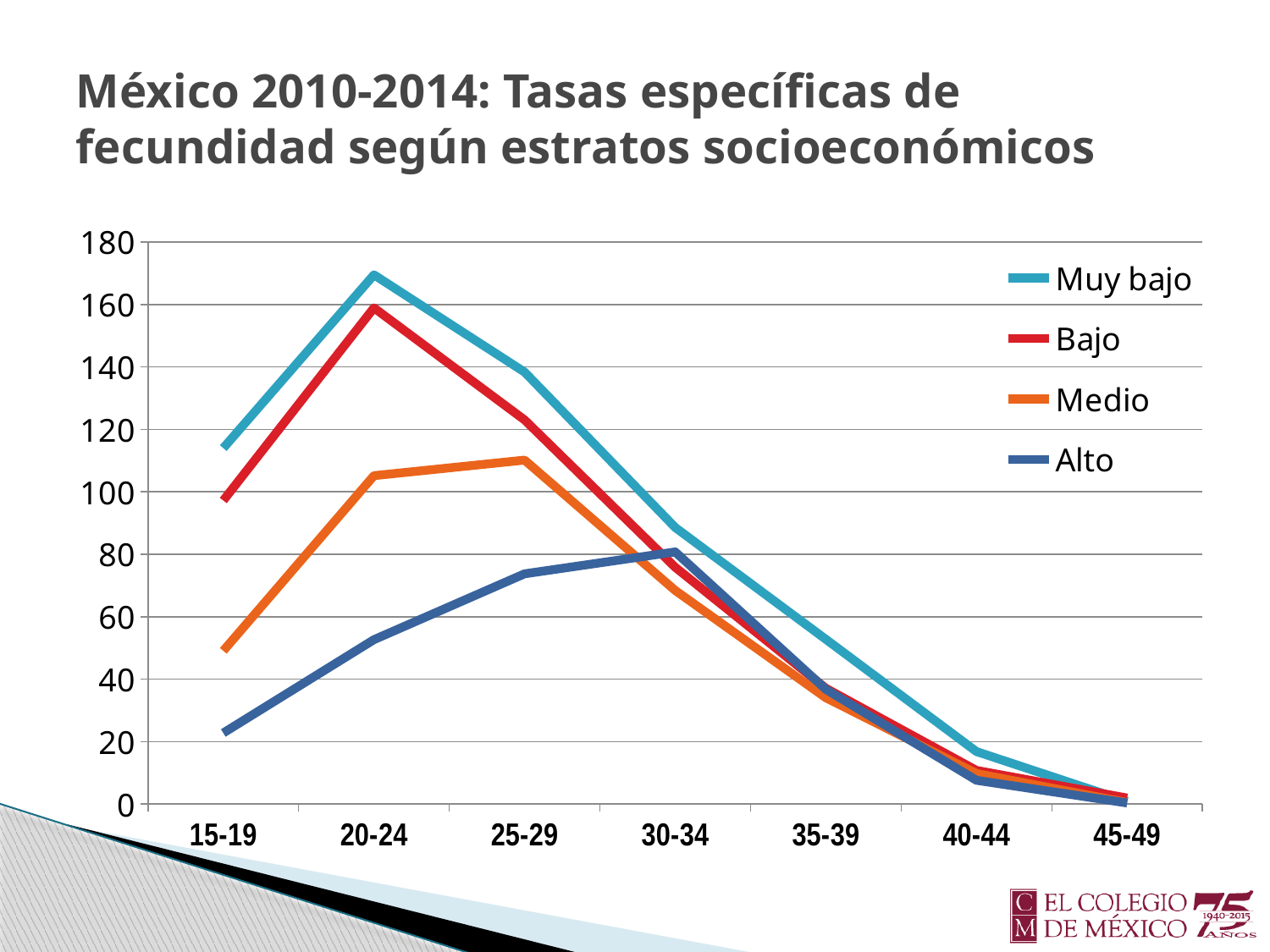
What kind of chart is shown on the slide? line chart Is the value for Alto at 15-19 greater or less than 40? less What colour is the line for the Bajo series? red At 15-19, which series has the larger value, Muy bajo or Alto? Muy bajo Do the values of the Muy bajo series rise or fall from 30-34 to 45-49? fall How many age groups are shown on the x axis? 7 For which age group is the Alto series highest? 30-34 For which age group is the Alto series lowest? 45-49 Is the value for Muy bajo at 20-24 greater or less than 160? greater How many series does the legend list? 4 Is the value for Medio at 20-24 greater or less than 100? greater For which age group is the Muy bajo series highest? 20-24